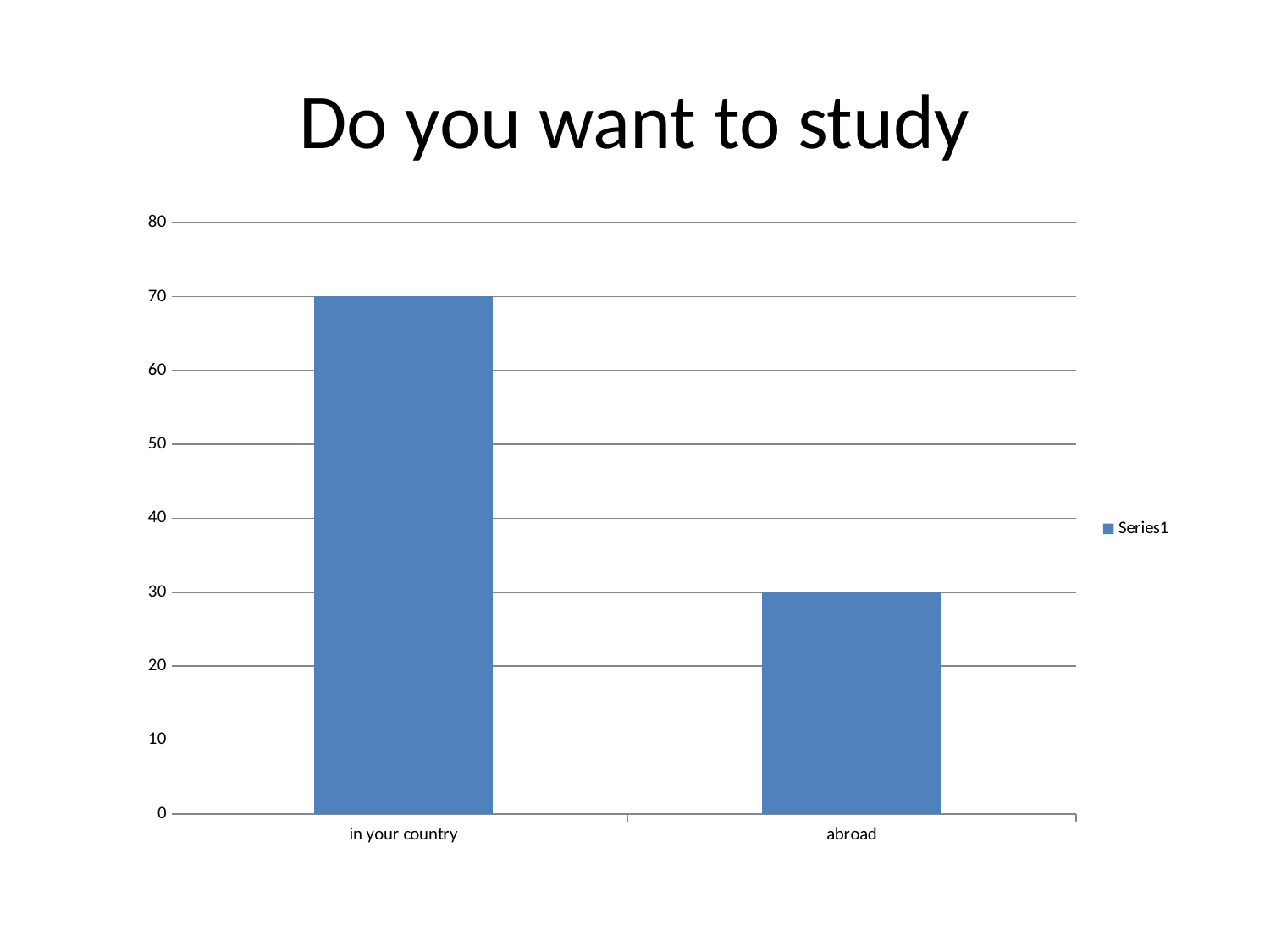
Which category has the highest value? in your country What kind of chart is shown on the slide? bar chart What is the difference between the values for "in your country" and "abroad"? 40 Is the value for "in your country" greater or less than 60? greater How many categories are shown on the x axis? 2 What is the title of the slide? Do you want to study Which is larger, the value for "in your country" or the value for "abroad"? in your country Is the value for "abroad" greater or less than 50? less How many series does the legend list? 1 What is the value for "in your country"? 70 Which category has the lowest value? abroad What is the value for "abroad"? 30